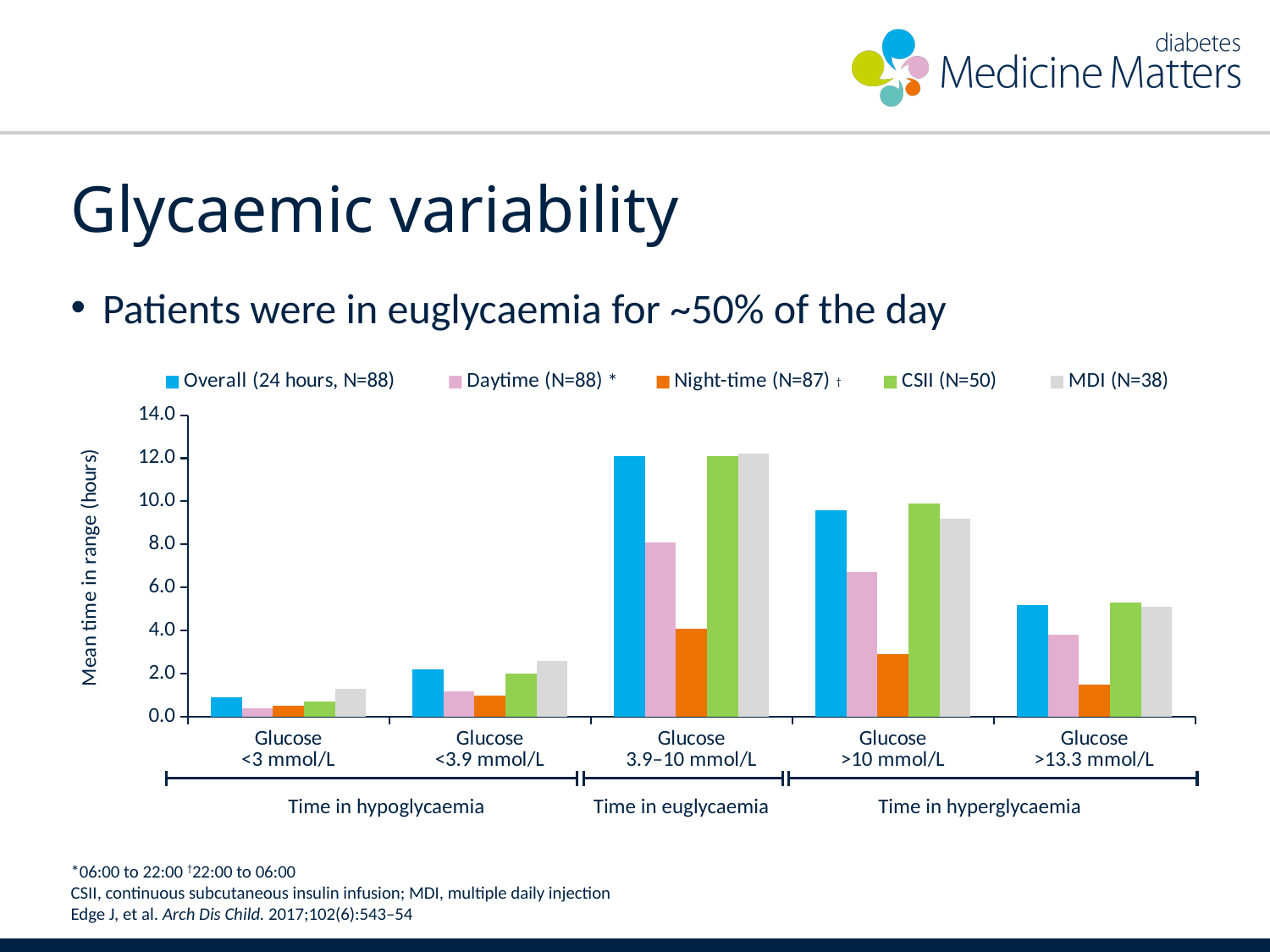
For which glucose range is the Overall (24 hours) bar the highest? Glucose 3.9–10 mmol/L Is the Overall (24 hours) value for Glucose 3.9–10 mmol/L greater or less than 10.0? greater For Glucose >13.3 mmol/L, which is larger: the Overall (24 hours) value or the Night-time value? Overall (24 hours) What kind of chart is shown on the slide? Bar chart Is the Night-time value for Glucose >10 mmol/L greater or less than 4.0? less How many glucose range categories are shown on the x axis? 5 How many series does the legend list? 5 For Glucose 3.9–10 mmol/L, which is larger: the Daytime value or the Night-time value? Daytime Which series has the lowest value for Glucose >10 mmol/L? Night-time (N=87) Is the Night-time value for Glucose 3.9–10 mmol/L greater or less than 6.0? less What is the title of the y axis? Mean time in range (hours)